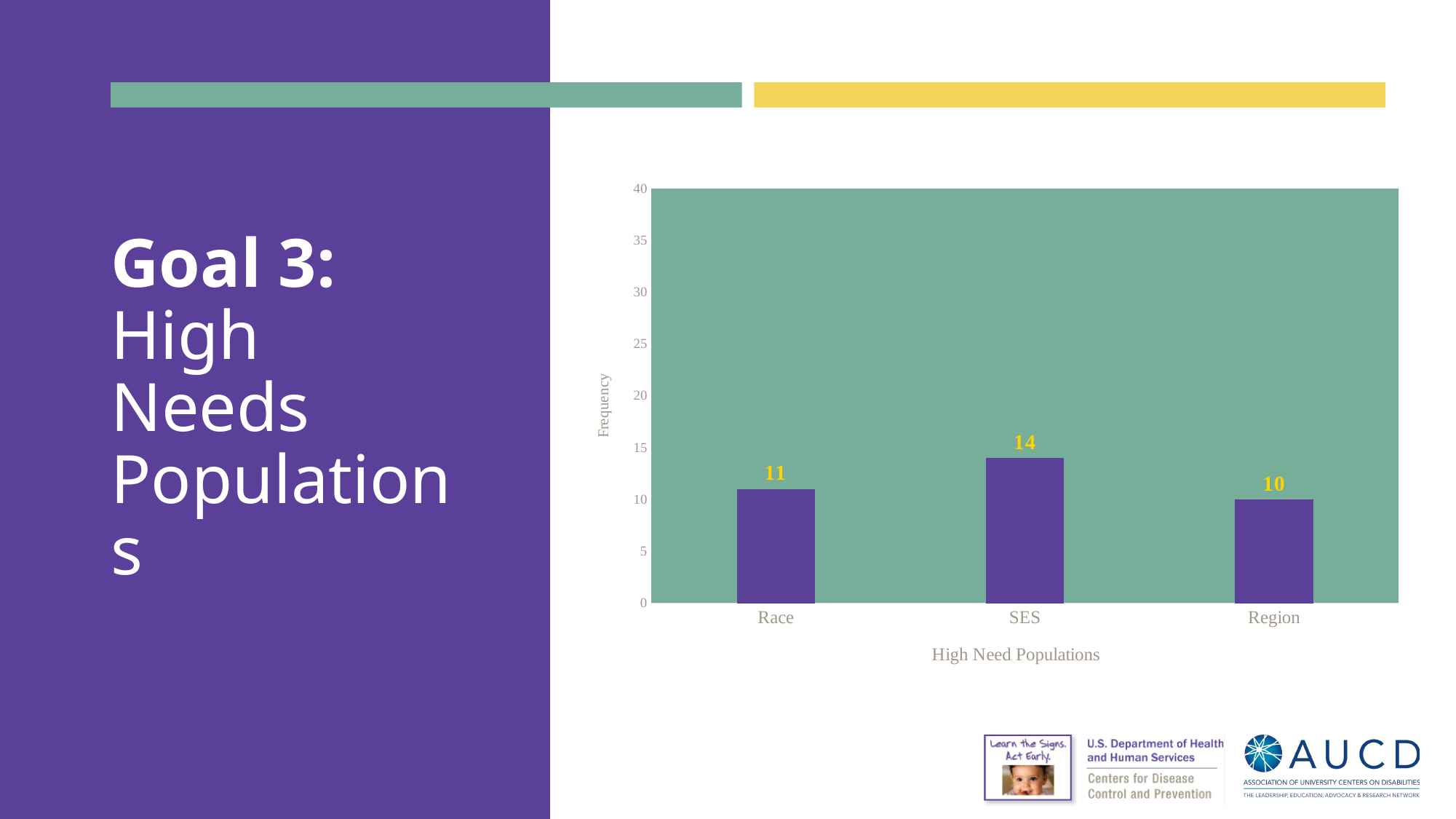
What is the frequency for Race? 11 What is the frequency for Region? 10 What is the frequency for SES? 14 What kind of chart is shown on the slide? bar chart What is the difference in frequency between SES and Race? 3 Which has a higher frequency, Race or Region? Race How many high need population categories are shown on the chart? 3 What is the difference in frequency between SES and Region? 4 Which high need population has the lowest frequency? Region Which high need population has the highest frequency? SES What is the label of the x axis? High Need Populations Is the frequency for SES greater or less than 20? less